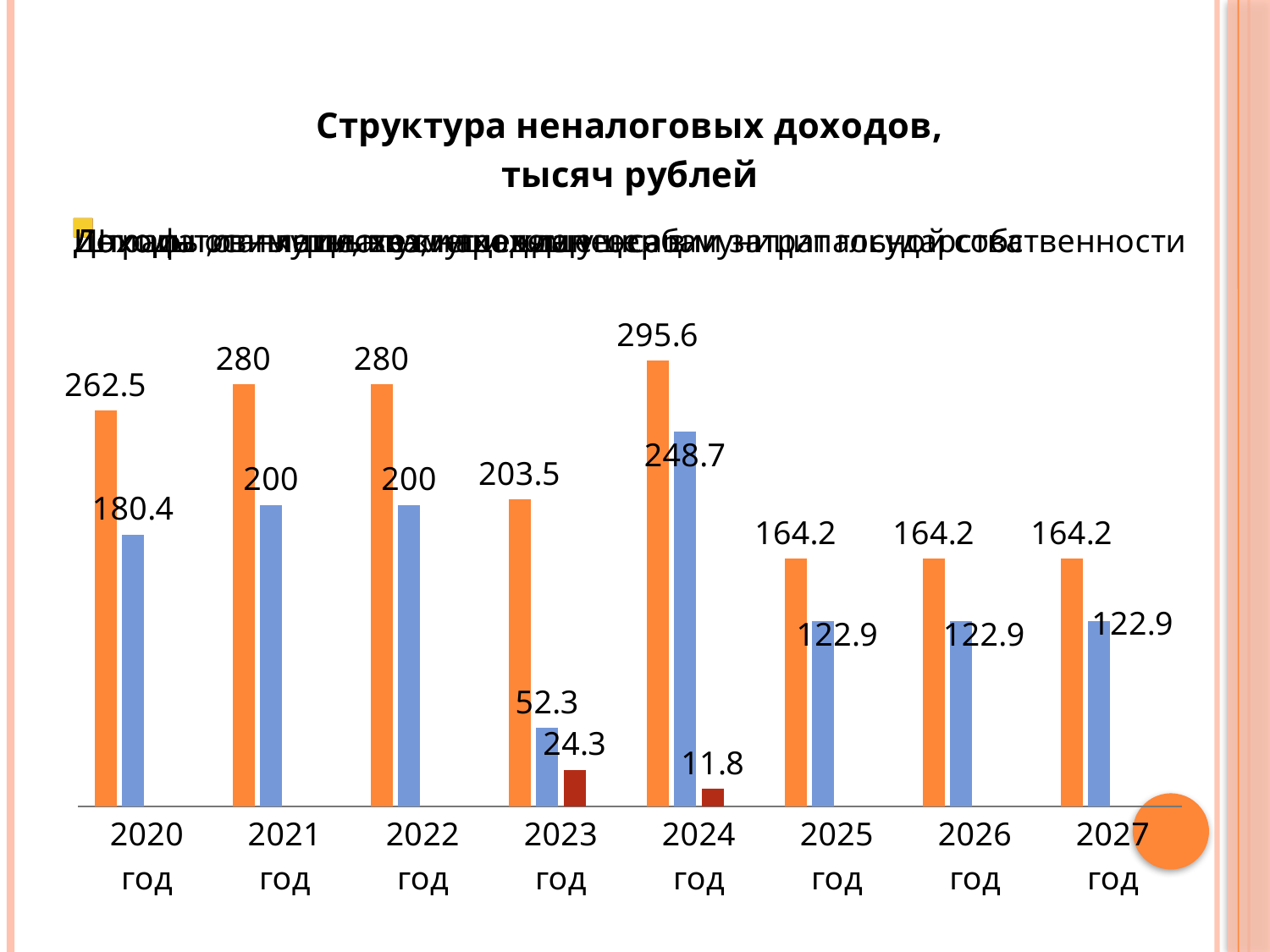
What type of chart is shown on the slide? bar chart In which year is the blue bar lowest? 2023 год What is the value of the dark red bar for 2024 год? 11.8 In which year is the orange bar highest? 2024 год What is the value of the dark red bar for 2023 год? 24.3 What is the difference between the orange bar and the blue bar for 2023 год? 151.2 Which is larger for 2024 год, the orange bar or the blue bar? the orange bar Do the orange bar values rise or fall from 2024 год to 2025 год? fall What is the value of the orange bar for 2024 год? 295.6 What is the title of the chart? Структура неналоговых доходов, тысяч рублей What is the value of the blue bar for 2020 год? 180.4 How many year categories are shown on the x axis? 8